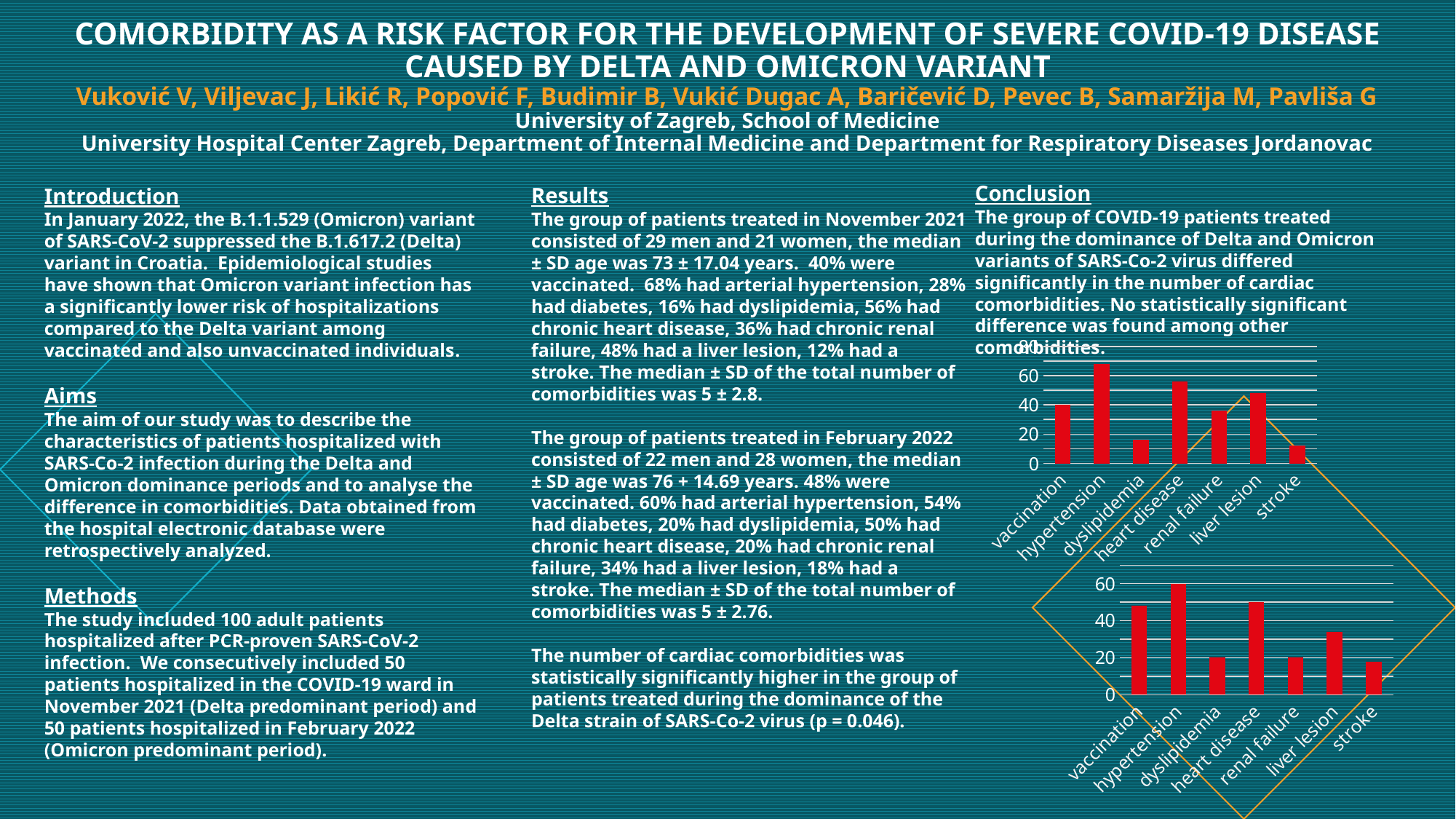
What colour are the bars in the two charts? red In the lower chart, which is larger, vaccination or liver lesion? vaccination In the upper chart, how many categories are shown on the x axis? 7 In the upper chart, which is larger, heart disease or renal failure? heart disease In the upper chart, which category has the lowest bar? stroke In the upper chart, is the value for stroke greater or less than 20? less In the lower chart, is the value for heart disease greater or less than 40? greater In the upper chart, which category has the highest bar? hypertension What type of chart is the upper chart on the right side of the slide? bar chart In the lower chart, which category has the highest bar? hypertension In the upper chart, is the value for hypertension greater or less than 60? greater